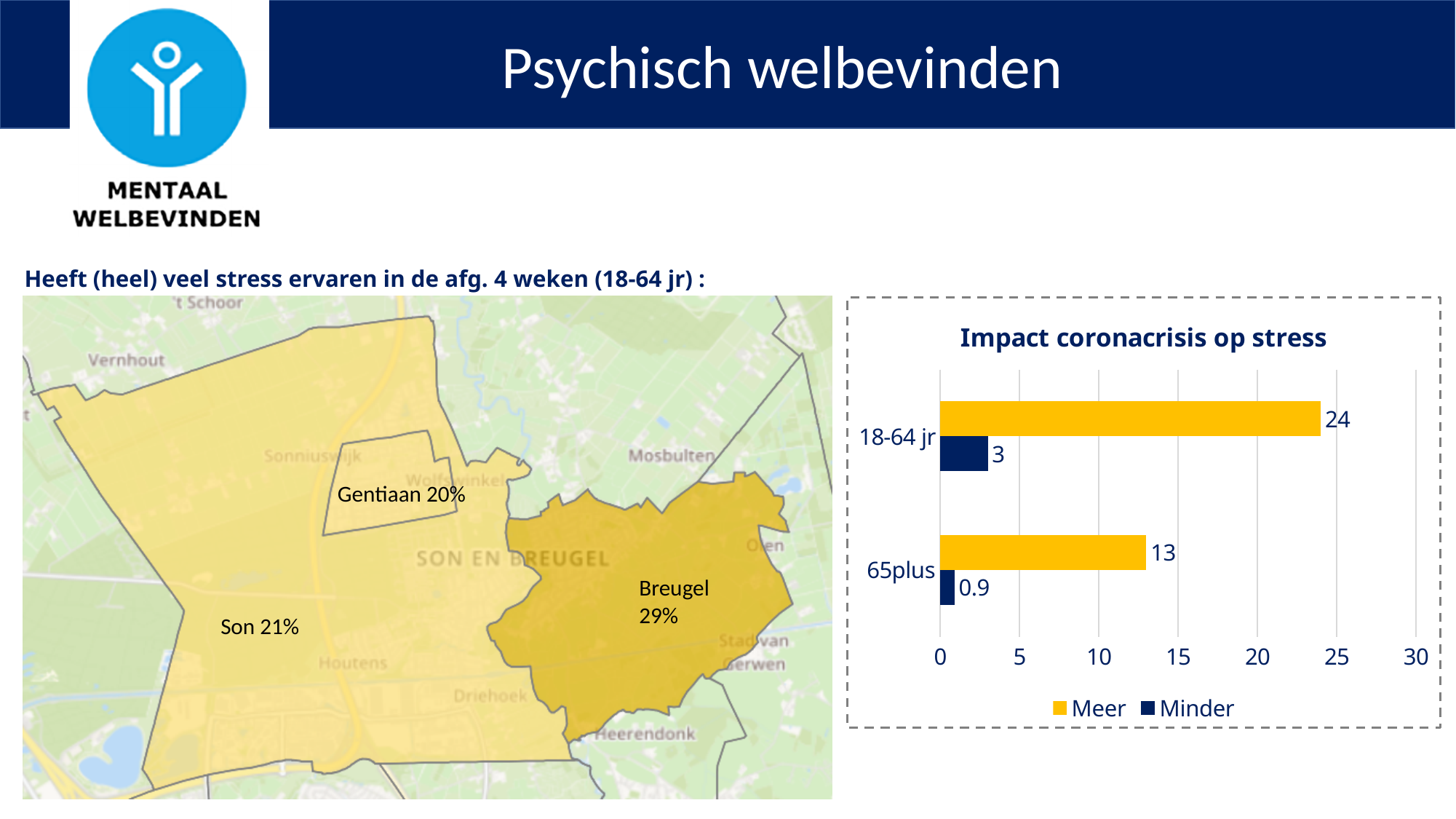
How many age groups are shown in the 'Impact coronacrisis op stress' chart? 2 In the 'Impact coronacrisis op stress' chart, what is the value for 'Meer' in the 65plus group? 13 In the 'Impact coronacrisis op stress' chart, what is the value for 'Minder' in the 65plus group? 0.9 How many series does the legend of the 'Impact coronacrisis op stress' chart list? 2 In the 'Impact coronacrisis op stress' chart, what is the value for 'Minder' in the 18-64 jr group? 3 What kind of chart is 'Impact coronacrisis op stress'? Bar chart In the 'Impact coronacrisis op stress' chart, which age group has the highest 'Meer' value? 18-64 jr In the 'Impact coronacrisis op stress' chart, which age group has the lowest 'Minder' value? 65plus In the 'Impact coronacrisis op stress' chart, what is the value for 'Meer' in the 18-64 jr group? 24 In the 'Impact coronacrisis op stress' chart, which is larger: 'Meer' for 65plus or 'Minder' for 18-64 jr? Meer for 65plus In the 'Impact coronacrisis op stress' chart, what is the difference between the 'Meer' values for 18-64 jr and 65plus? 11 In the 'Impact coronacrisis op stress' chart, is the 'Meer' value for 18-64 jr greater or less than 20? greater